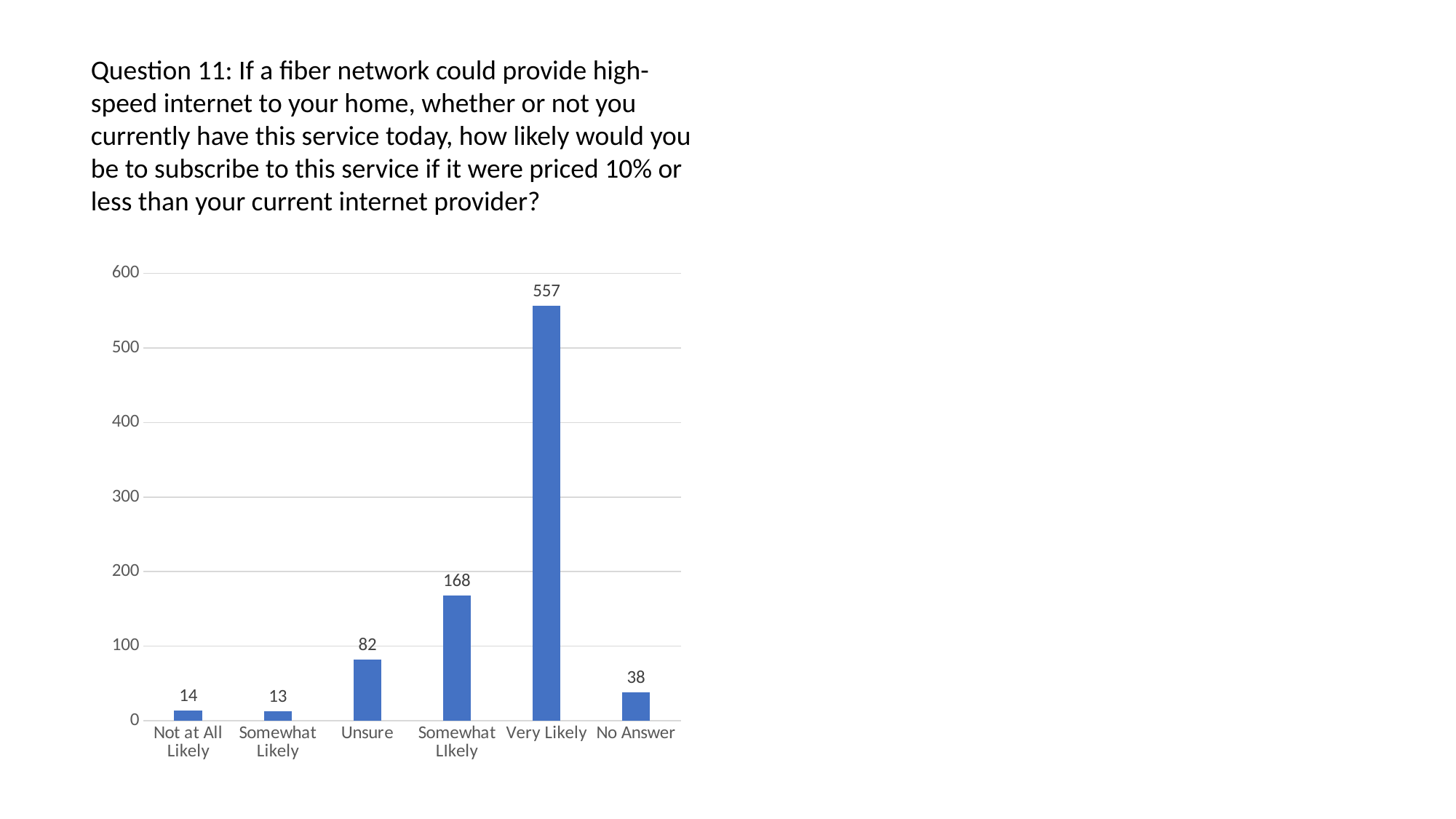
Which is larger, the value for Unsure or the value for No Answer? Unsure Which category has the lowest value? Somewhat Likely What is the value for Very Likely? 557 How many categories are shown on the x axis? 6 What is the value for Unsure? 82 What is the value for No Answer? 38 What is the difference between the values for Very Likely and Somewhat Likely (the fourth bar, 168)? 389 Which category has the highest value? Very Likely Is the value for Very Likely greater or less than 500? greater What kind of chart is shown on the slide? Bar chart What is the difference between the values for Unsure and No Answer? 44